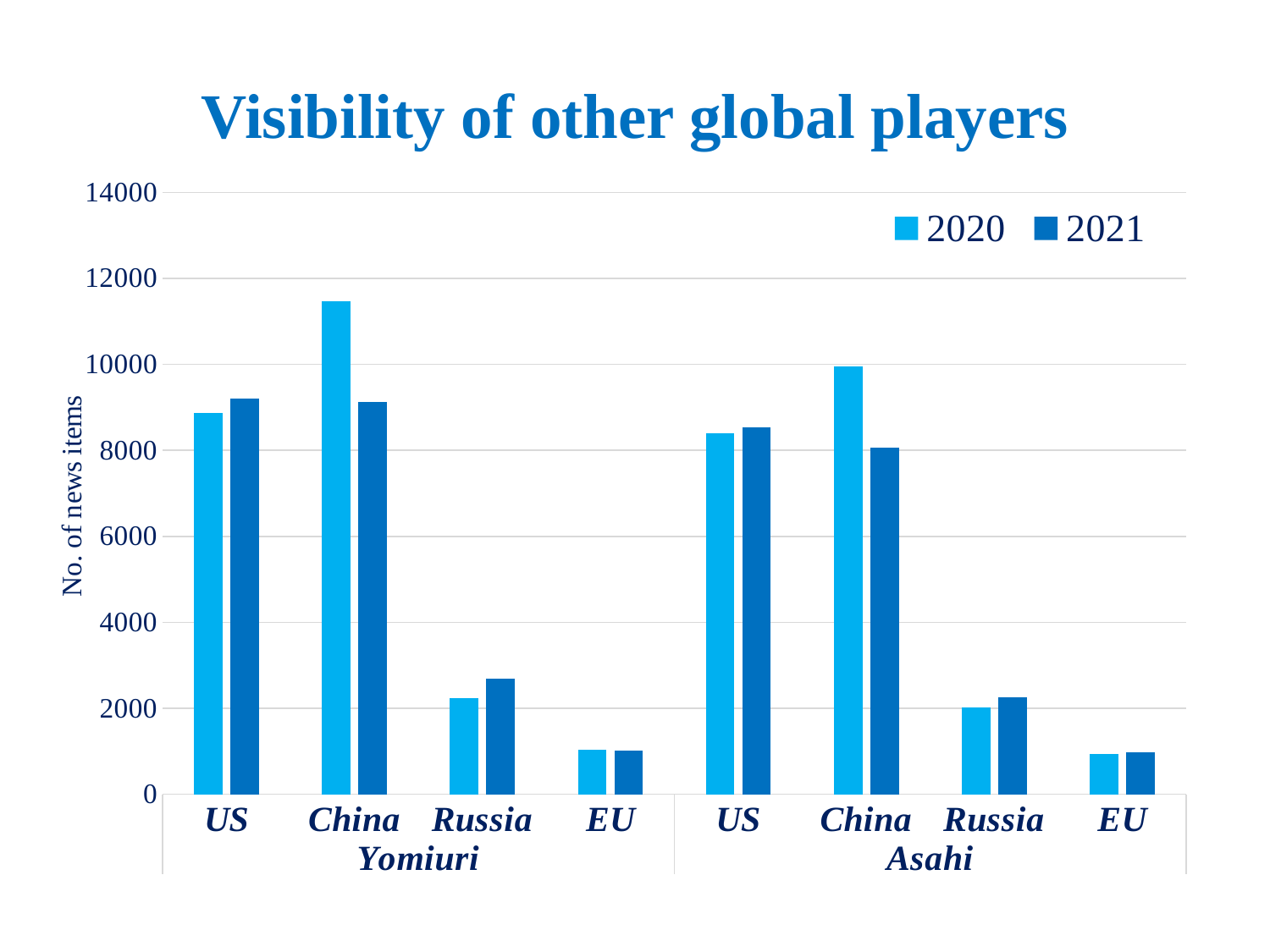
How many series does the legend list? 2 For Russia under Asahi, which year has the larger value, 2020 or 2021? 2021 How many category groups (country bars pairs) are plotted along the x axis in total? 8 For China under Yomiuri, which year has the larger value, 2020 or 2021? 2020 What is the label on the vertical axis? No. of news items Which country has the lowest values in the Asahi group? EU Which bar is the tallest in the whole chart? China 2020 (Yomiuri) Is the 2020 value for US under Asahi greater or less than 8000? greater What kind of chart is shown on the slide? bar chart Is the 2021 value for Russia under Yomiuri greater or less than 2000? greater Is the 2020 value for China under Yomiuri greater or less than 10000? greater